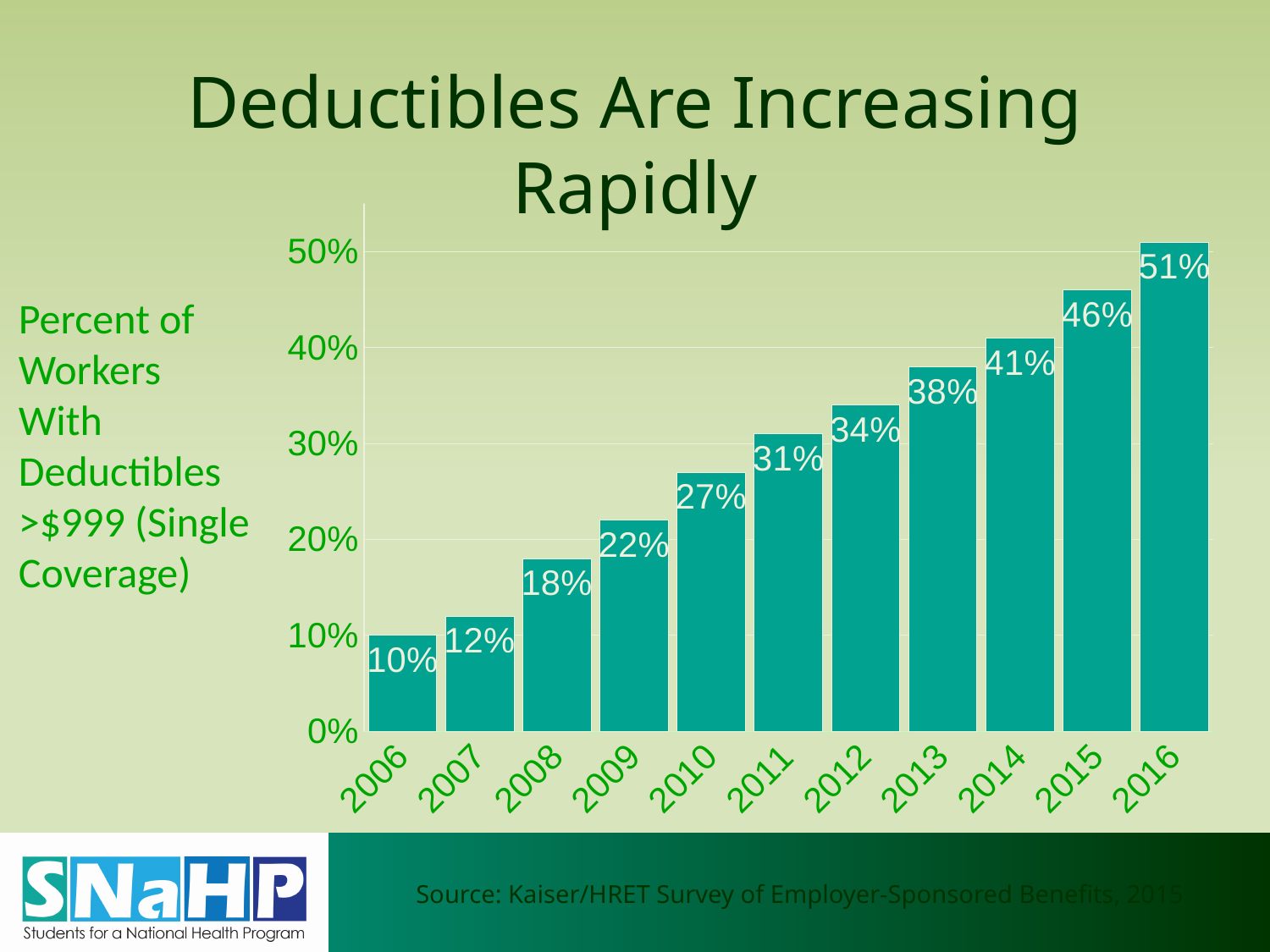
What percent of workers had deductibles >$999 in 2010? 27% What is the value shown for 2016? 51% Which year has the highest value? 2016 What is the difference between the values for 2016 and 2006? 41% Is the value for 2014 greater or less than 40%? greater What is the value shown for 2006? 10% How many years are shown on the x axis? 11 Which is larger, the value for 2009 or the value for 2011? 2011 Do the values rise or fall from 2006 to 2016? rise What is the difference between the values for 2013 and 2012? 4% Which year has the lowest value? 2006 What kind of chart is shown on the slide? bar chart